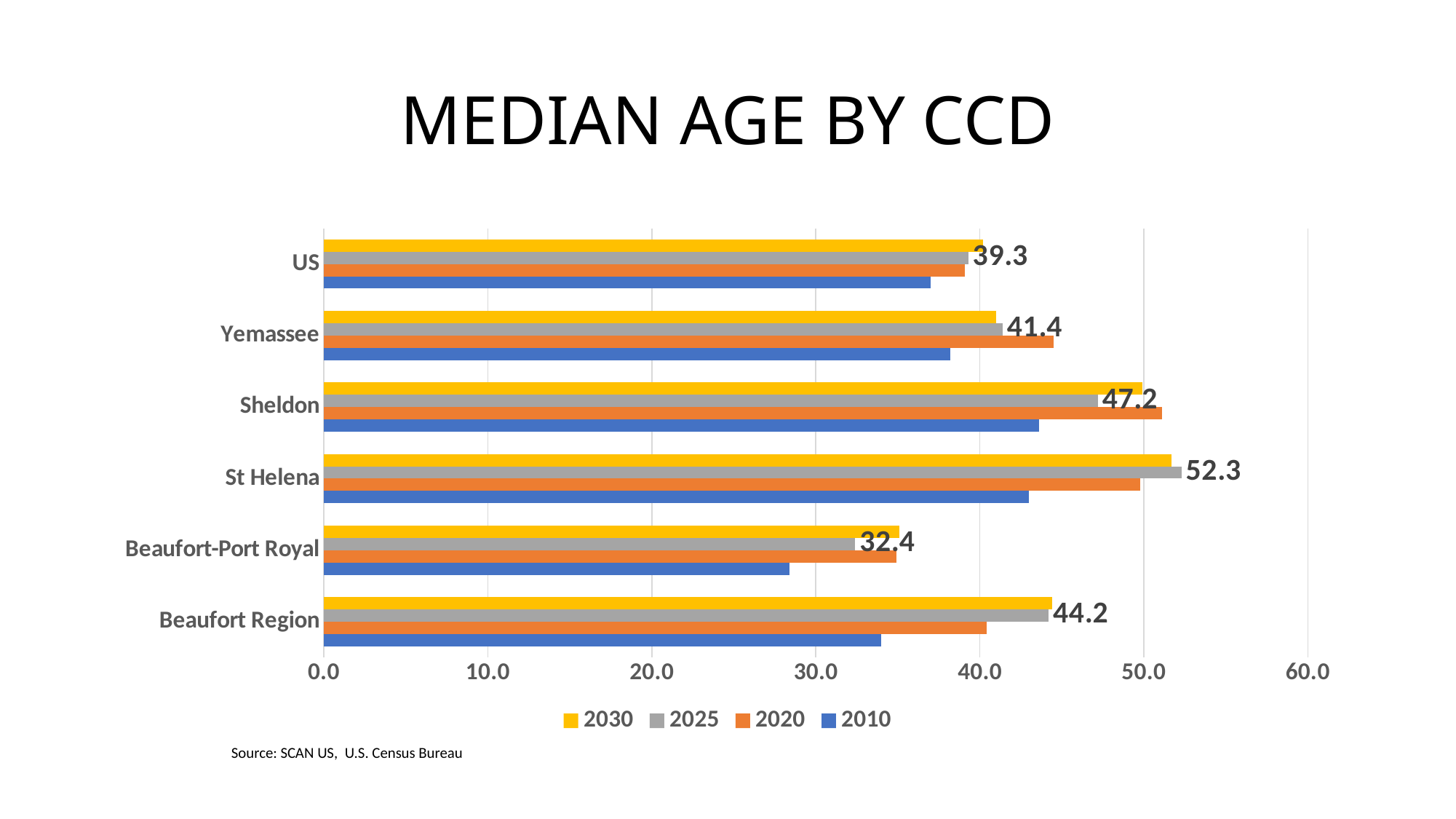
What is the 2025 median age for Beaufort-Port Royal? 32.4 How many series does the legend list? 4 What is the difference between the 2025 median age of Sheldon and that of Yemassee? 5.8 What is the 2025 median age for the US? 39.3 Is the 2030 median age for St Helena greater or less than 50.0? greater Which has a higher 2025 median age, Beaufort Region or the US? Beaufort Region What type of chart is shown on the slide? Bar chart Which CCD has the lowest 2025 median age? Beaufort-Port Royal Is the 2010 median age for Beaufort-Port Royal greater or less than 30.0? less What is the 2025 median age for St Helena? 52.3 Which CCD has the highest 2025 median age? St Helena How many CCD categories are shown on the chart? 6